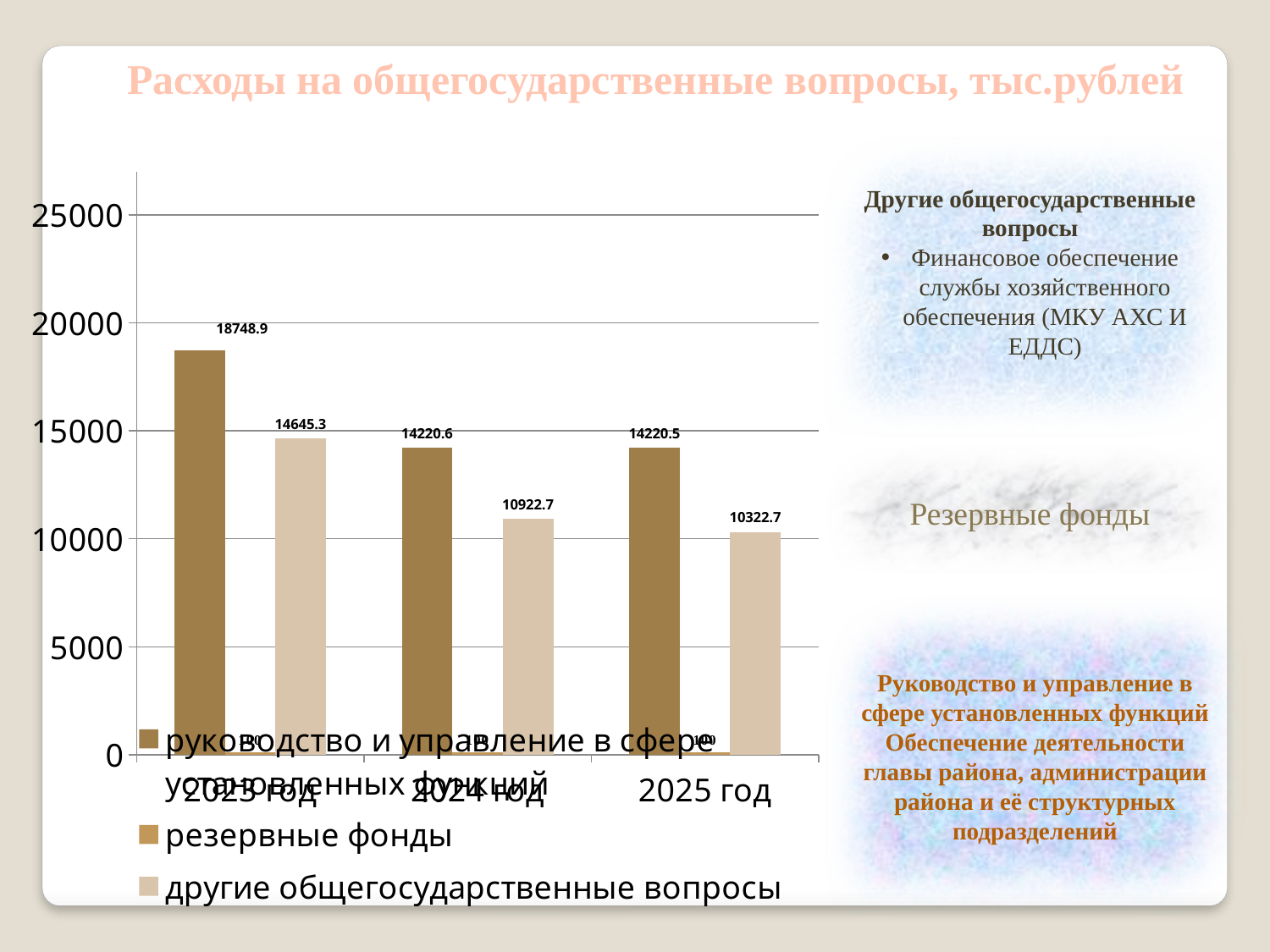
By how much does другие общегосударственные вопросы in 2024 год exceed the same series in 2025 год? 600 What is the value for руководство и управление в сфере установленных функций in 2023 год? 18748.9 In which year is the value for руководство и управление в сфере установленных функций highest? 2023 год How many years are shown on the x axis? 3 What is the value for другие общегосударственные вопросы in 2025 год? 10322.7 Does the value for руководство и управление в сфере установленных функций rise or fall from 2023 год to 2025 год? fall Is the value for резервные фонды in 2023 год greater or less than 5000? less What is the value for другие общегосударственные вопросы in 2024 год? 10922.7 What is the difference between руководство и управление в сфере установленных функций and другие общегосударственные вопросы in 2023 год? 4103.6 Which is larger in 2024 год: руководство и управление в сфере установленных функций or другие общегосударственные вопросы? руководство и управление в сфере установленных функций In which year is the value for другие общегосударственные вопросы lowest? 2025 год How many series does the legend list? 3